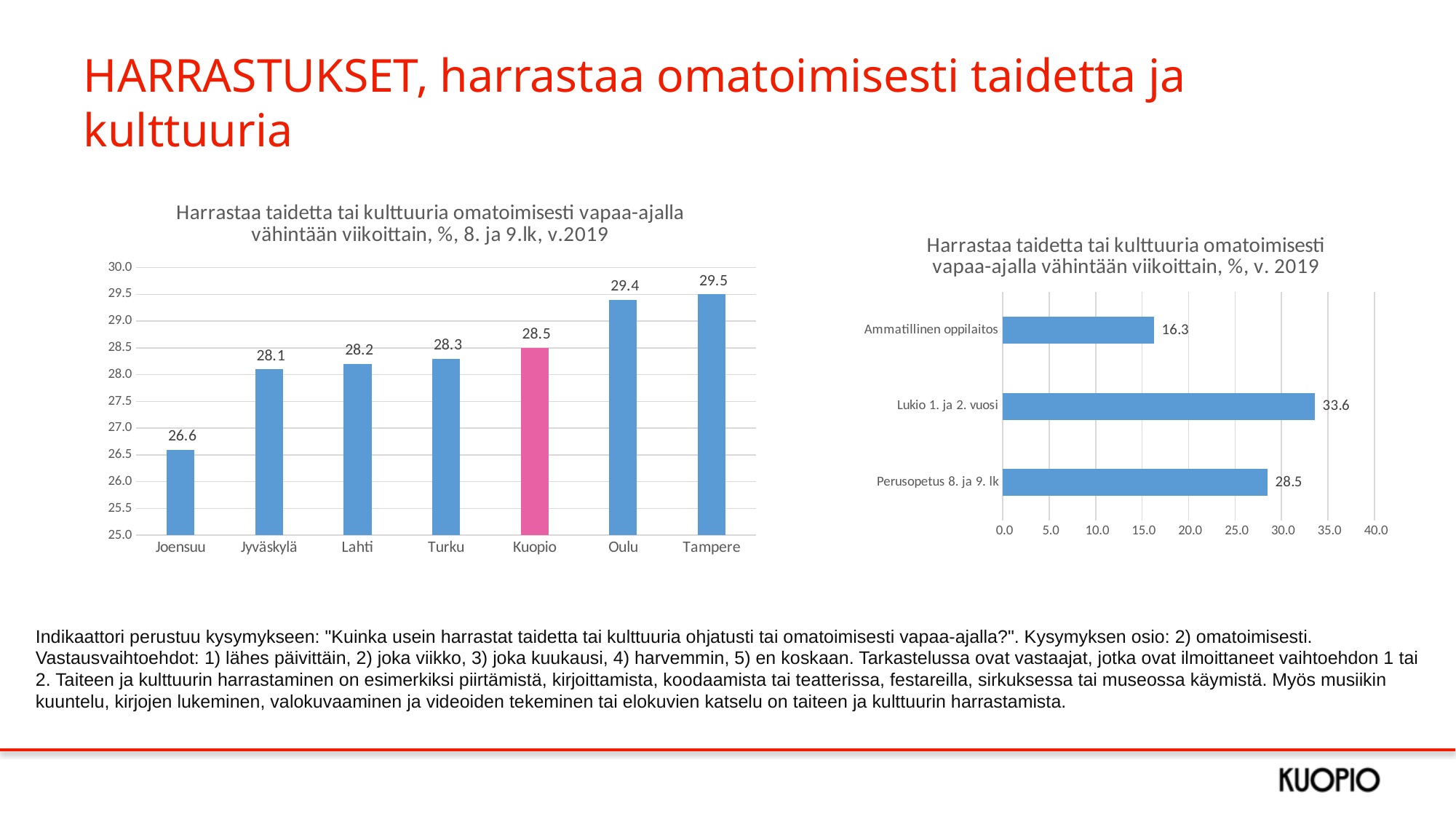
In the left chart (8. ja 9.lk by city), how many cities are shown? 7 In the right chart (by school level, v. 2019), what is the difference between Lukio 1. ja 2. vuosi and Ammatillinen oppilaitos? 17.3 In the left chart (8. ja 9.lk by city), what is the value for Kuopio? 28.5 In the left chart (8. ja 9.lk by city), which bar is coloured pink instead of blue? Kuopio In the left chart (8. ja 9.lk by city), what is the difference between Tampere and Joensuu? 2.9 In the right chart (by school level, v. 2019), what is the value for Lukio 1. ja 2. vuosi? 33.6 In the left chart (8. ja 9.lk by city), which is larger, the value for Oulu or the value for Turku? Oulu In the left chart (8. ja 9.lk by city), what is the value for Joensuu? 26.6 In the left chart (8. ja 9.lk by city), which city has the lowest value? Joensuu In the right chart (by school level, v. 2019), which category has the lowest value? Ammatillinen oppilaitos What kind of chart is the right chart (by school level, v. 2019)? Bar chart In the left chart (8. ja 9.lk by city), which city has the highest value? Tampere